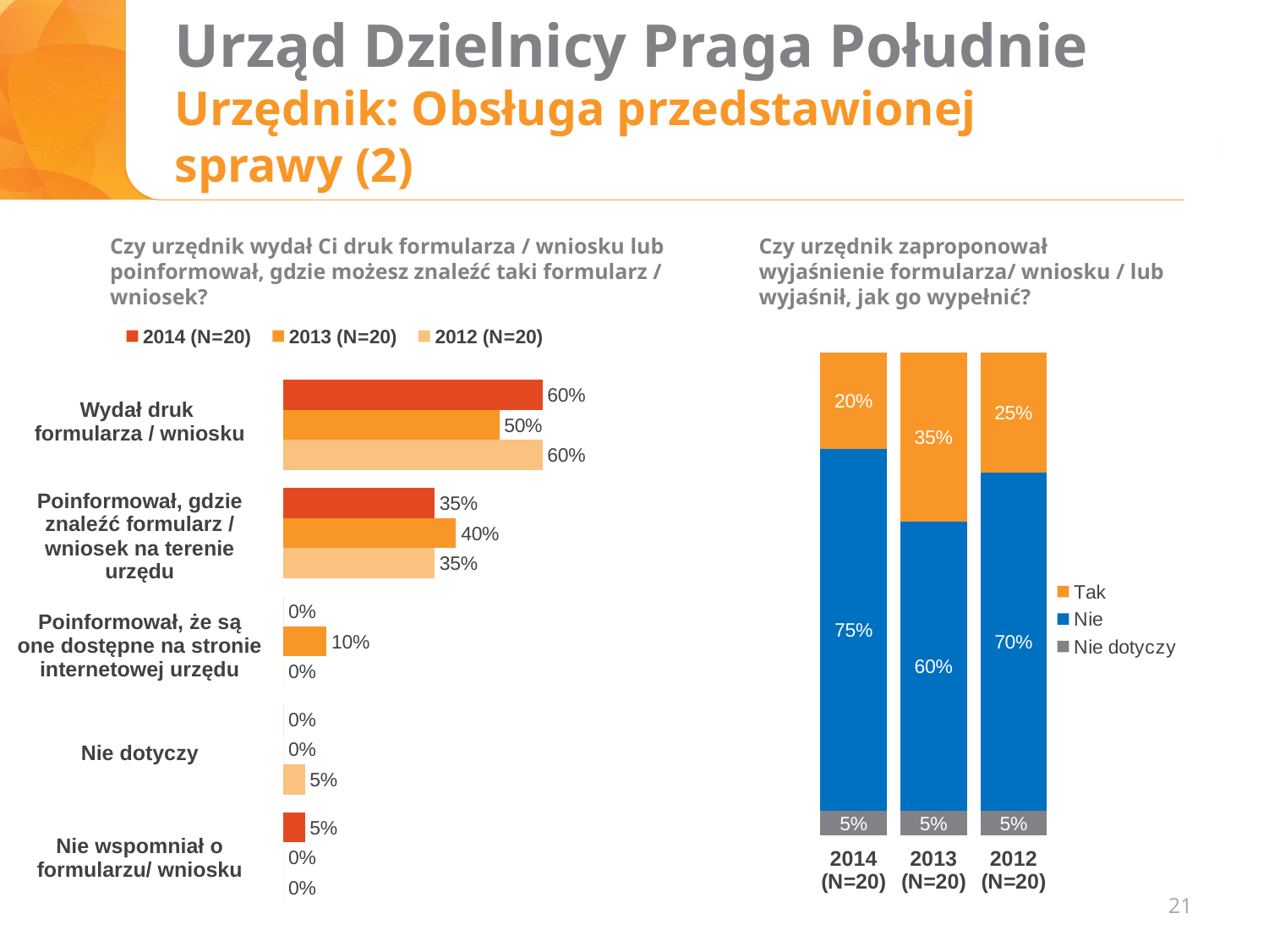
In the left chart, what is the 2013 (N=20) value for 'Poinformował, gdzie znaleźć formularz / wniosek na terenie urzędu'? 40% In the left chart, what is the 2012 (N=20) value for 'Nie dotyczy'? 5% In the right chart, which year has the highest 'Tak' share? 2013 (N=20) In the left chart, how many categories are shown? 5 In the left chart, which category has the highest value in the 2014 (N=20) series? Wydał druk formularza / wniosku In the left chart, how many series does the legend list? 3 In the left chart, what is the difference between the 2014 and 2013 values for 'Wydał druk formularza / wniosku'? 10% In the left chart, what is the value for 'Wydał druk formularza / wniosku' in the 2013 (N=20) series? 50% In the right chart, what is the 'Nie' share for 2013 (N=20)? 60% In the right chart, what is the 'Tak' share for 2012 (N=20)? 25% In the right chart, what is the total of the 2014 (N=20) stacked bar? 100% What kind of chart is the chart on the right? Stacked bar chart